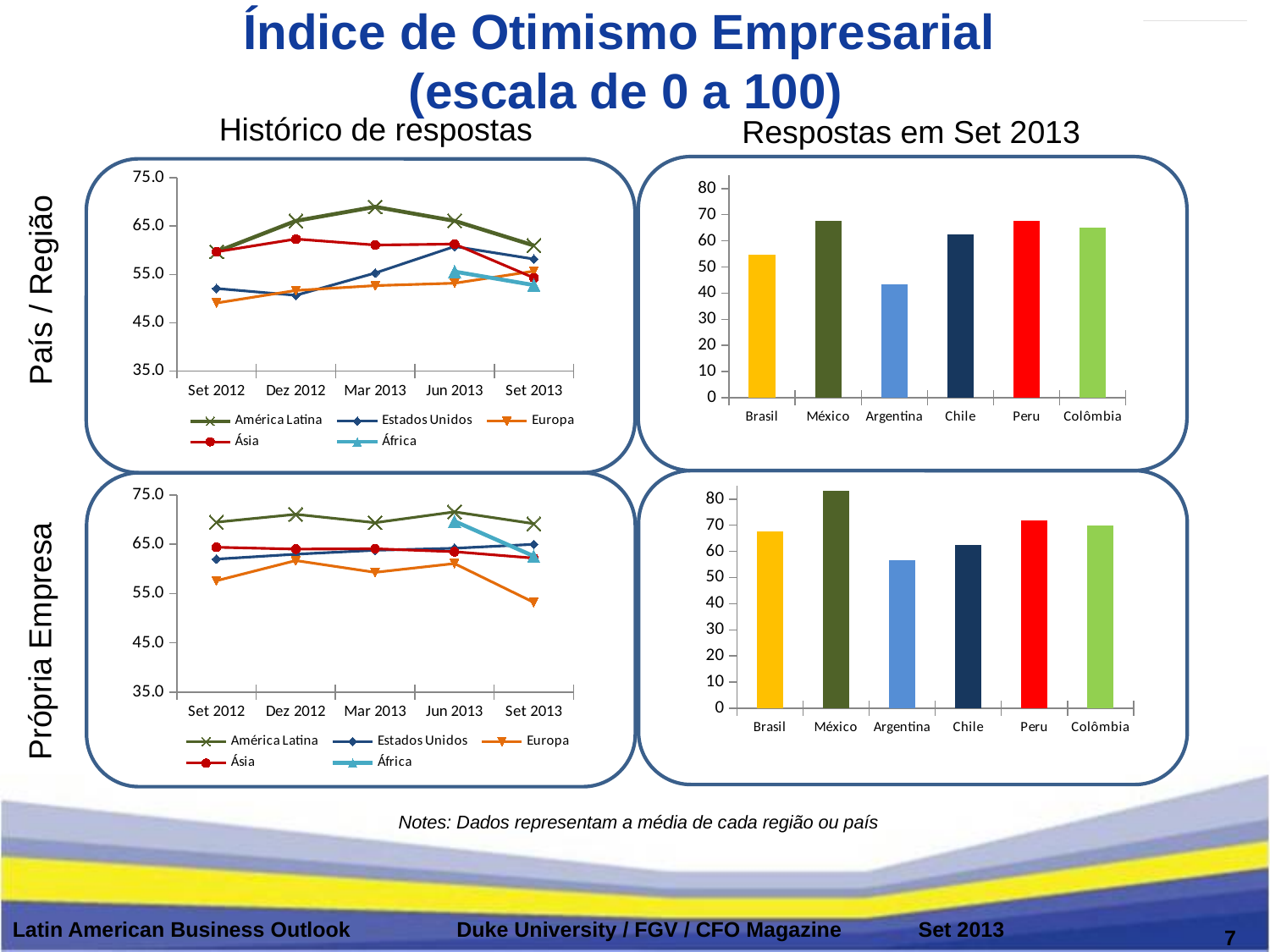
In the top-left line chart (Histórico de respostas, País / Região), does the América Latina series rise or fall from Jun 2013 to Set 2013? fall In the top-right bar chart (Respostas em Set 2013, País / Região), which is larger, the value for Chile or the value for Argentina? Chile In the bottom-right bar chart (Respostas em Set 2013, Própria Empresa), which is larger, the value for Peru or the value for Chile? Peru In the bottom-right bar chart (Respostas em Set 2013, Própria Empresa), how many countries are shown? 6 In the bottom-left line chart (Histórico de respostas, Própria Empresa), how many time points are shown on the x axis? 5 In the bottom-right bar chart (Respostas em Set 2013, Própria Empresa), which country has the highest value? México In the top-right bar chart (Respostas em Set 2013, País / Região), is the value for Argentina greater or less than 50? less In the top-left line chart (Histórico de respostas, País / Região), which series has the highest value at Mar 2013? América Latina What kind of chart is the top-right chart (Respostas em Set 2013, País / Região)? bar chart In the top-left line chart (Histórico de respostas, País / Região), how many series does the legend list? 5 In the bottom-right bar chart (Respostas em Set 2013, Própria Empresa), is the value for México greater or less than 80? greater In the top-right bar chart (Respostas em Set 2013, País / Região), which country has the lowest value? Argentina